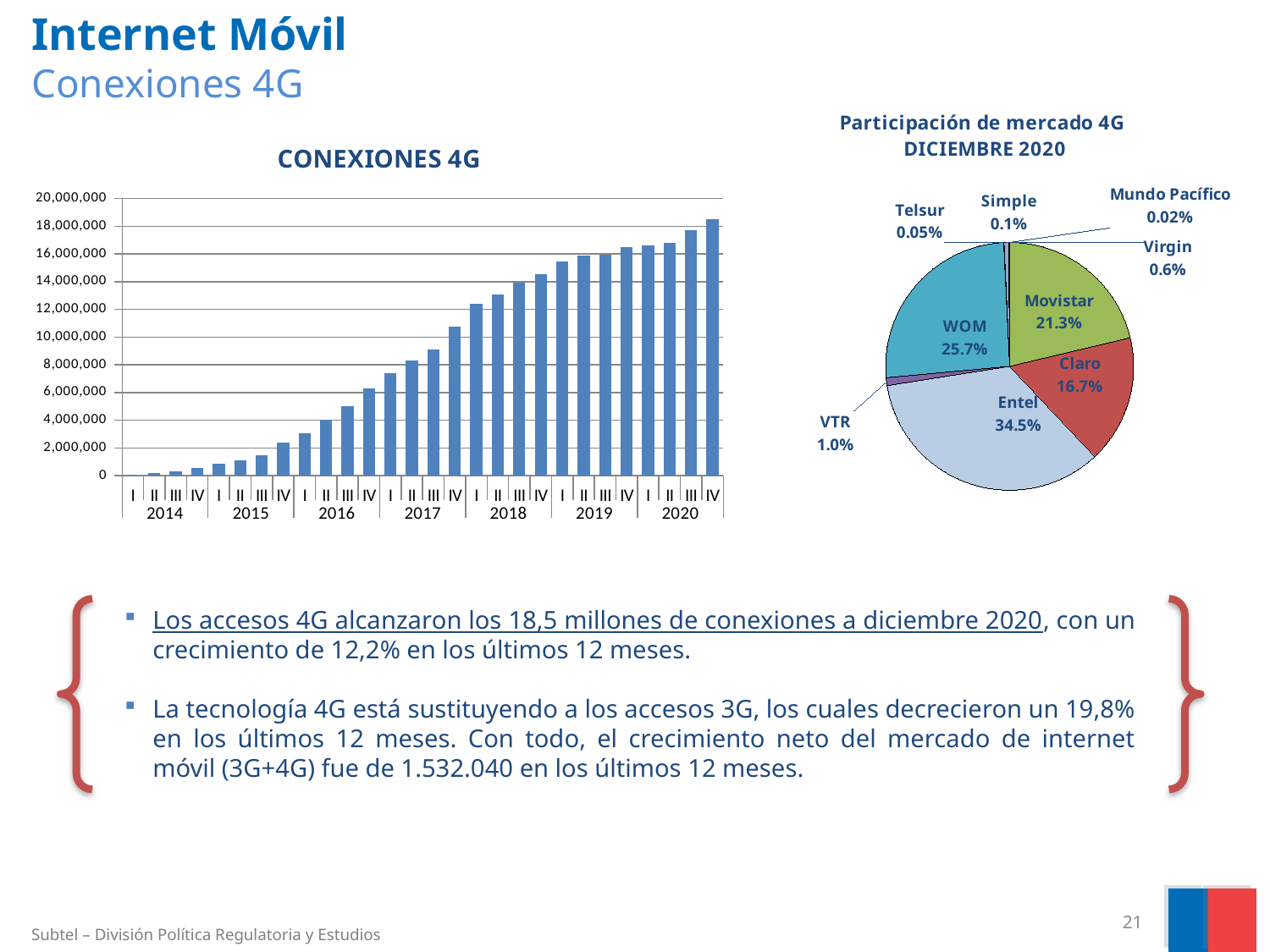
In the 'Participación de mercado 4G DICIEMBRE 2020' pie chart, what is Entel's share? 34.5% In the 'CONEXIONES 4G' bar chart, is the value for quarter IV of 2017 greater or less than 10,000,000? greater What type of chart is the 'Participación de mercado 4G DICIEMBRE 2020' chart on the right? Pie chart In the 'Participación de mercado 4G DICIEMBRE 2020' pie chart, which operator has the largest share? Entel In the 'CONEXIONES 4G' bar chart, is the value for quarter IV of 2020 greater or less than 18,000,000? greater How many operators are shown in the 'Participación de mercado 4G DICIEMBRE 2020' pie chart? 9 In the 'Participación de mercado 4G DICIEMBRE 2020' pie chart, which operator has the smallest share? Mundo Pacífico What type of chart is the 'CONEXIONES 4G' chart on the left? Bar chart In the 'Participación de mercado 4G DICIEMBRE 2020' pie chart, which is larger, WOM's share or Movistar's share? WOM In the 'CONEXIONES 4G' bar chart, do the values rise or fall from 2014 to 2020? Rise In the 'Participación de mercado 4G DICIEMBRE 2020' pie chart, what is the difference between Movistar's and Claro's shares? 4.6% In the 'Participación de mercado 4G DICIEMBRE 2020' pie chart, what is WOM's share? 25.7%